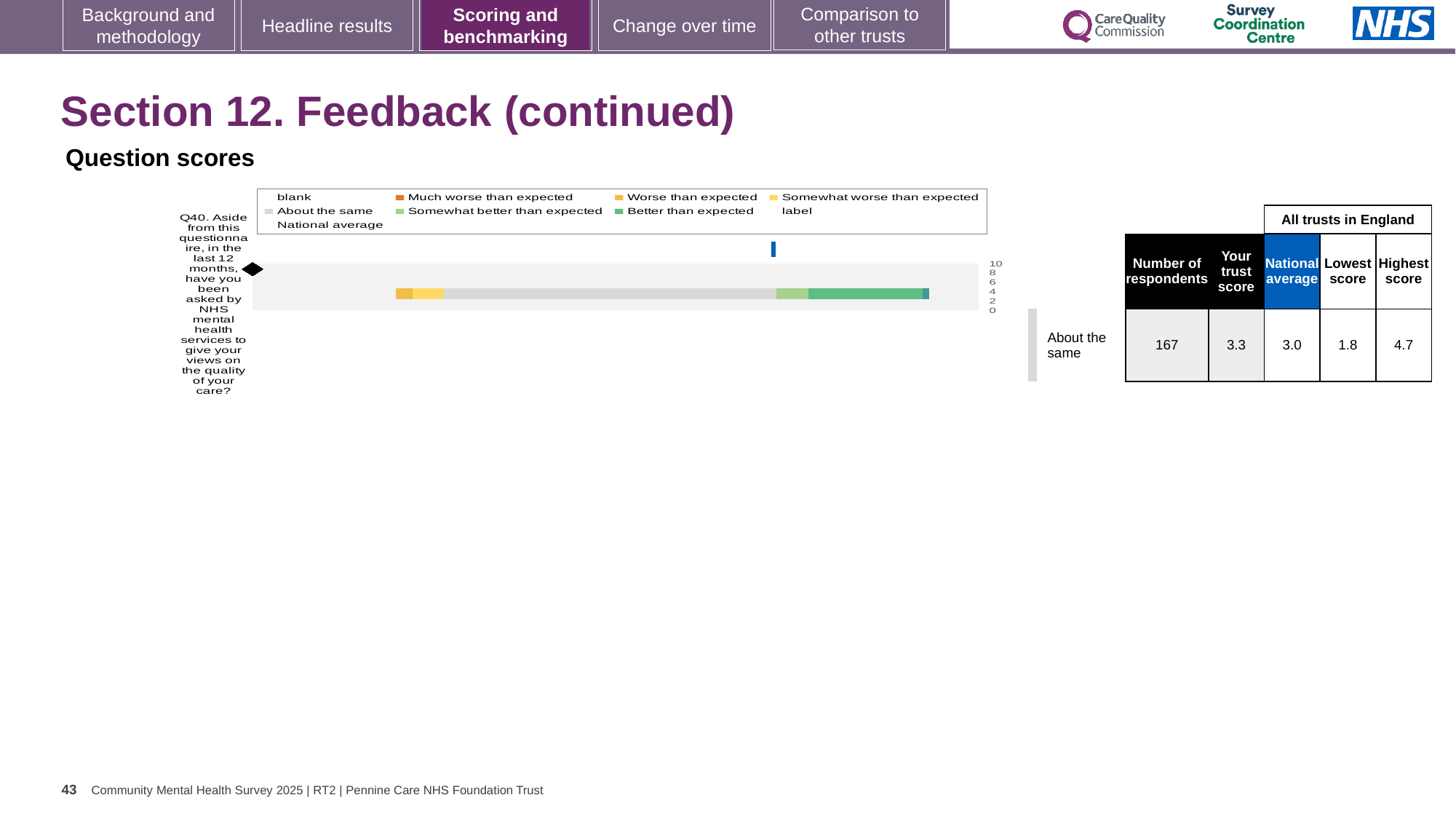
What is the difference between the highest and lowest scores for Q40 across all trusts in England? 2.9 How many survey questions are plotted on the chart? 1 What is the highest score among all trusts in England for Q40? 4.7 Which is larger for Q40: the trust's score or the national average? the trust's score How many respondents answered Q40? 167 Which benchmarking category does the trust's Q40 score fall into? About the same By how much does the trust's score for Q40 exceed the national average? 0.3 What kind of chart is used to show the Q40 benchmarking result? bar chart What colour represents 'Better than expected' in the chart legend? green What is the trust's score for Q40 shown alongside the chart? 3.3 What is the national average score for Q40? 3.0 What is the lowest score among all trusts in England for Q40? 1.8